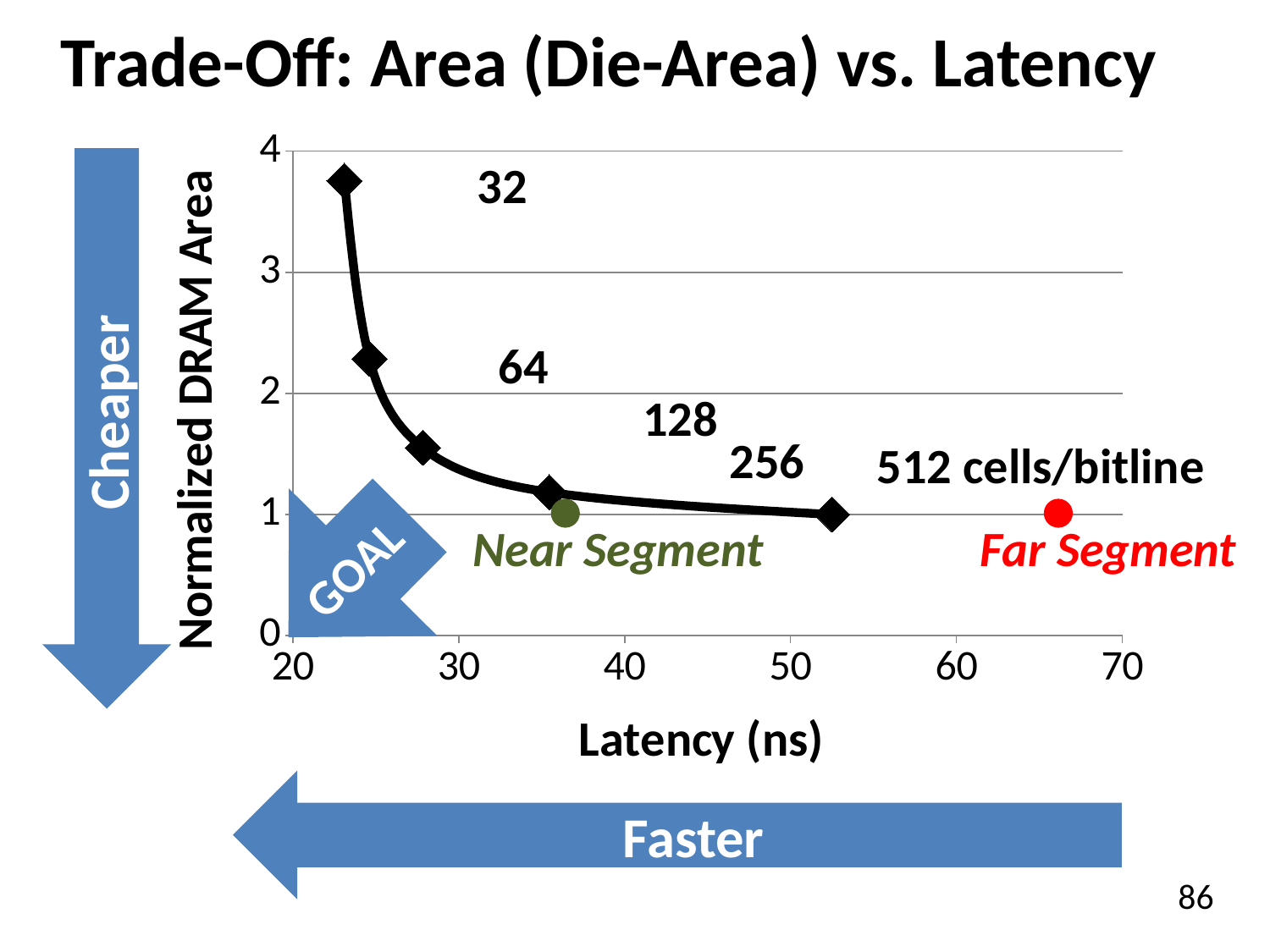
Is the latency of the Far Segment point greater or less than 60 ns? greater As latency increases along the x axis, does the normalized DRAM area rise or fall? fall How many black diamond data points are plotted on the curve? 5 Which cells/bitline configuration has the lowest normalized DRAM area? 512 Which cells/bitline configuration has the lowest latency? 32 What is the title of the y axis? Normalized DRAM Area Is the normalized DRAM area for 128 cells/bitline greater or less than 2? less Is the normalized DRAM area for 32 cells/bitline greater or less than 3? greater Which cells/bitline configuration has the highest normalized DRAM area? 32 What is the title of the x axis? Latency (ns) What is the normalized DRAM area for 512 cells/bitline? 1 What kind of chart is shown on the slide? line chart